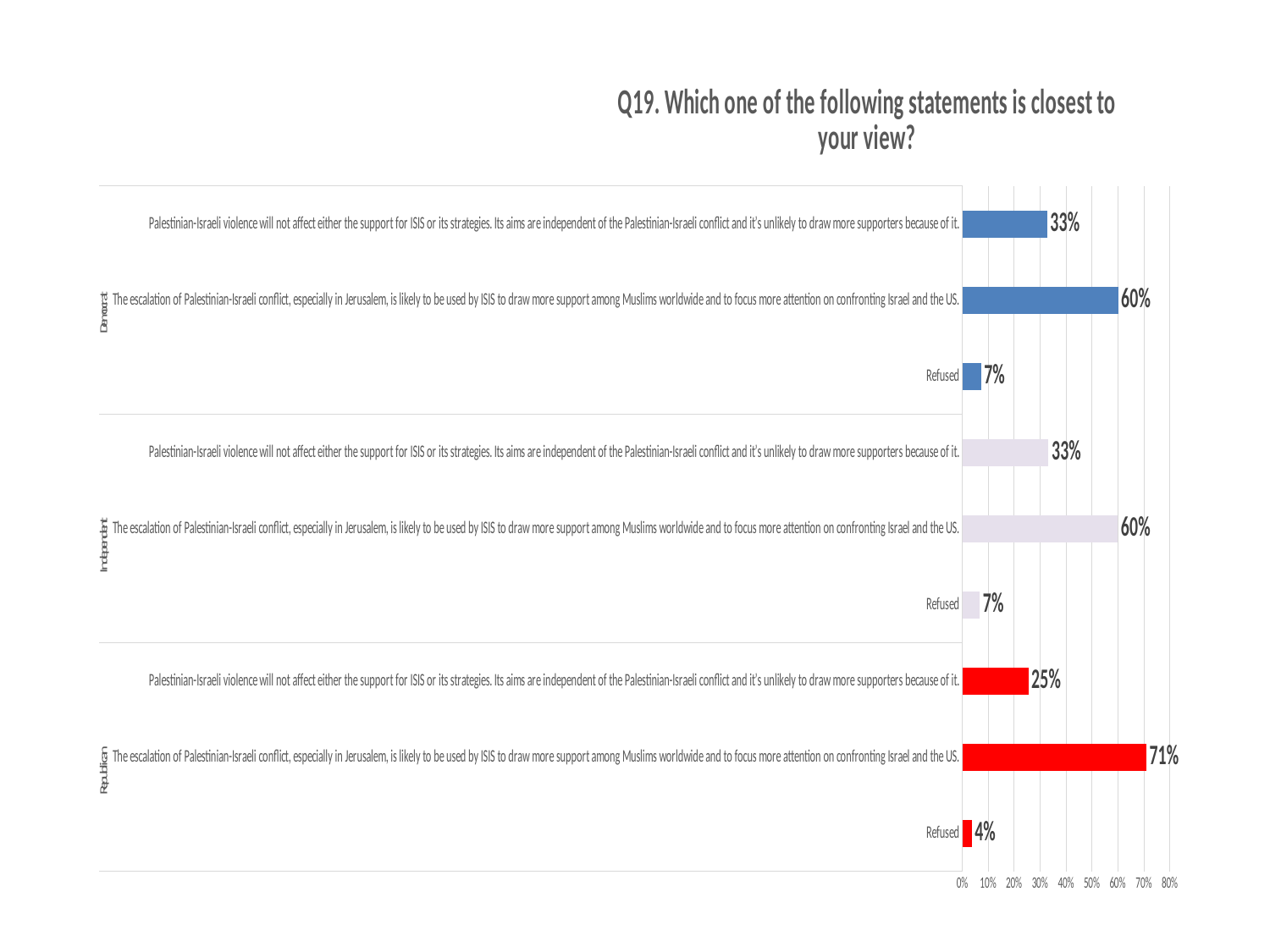
What is the value for Refused among Independents? 7% Which bar has the lowest value on the chart? Republican – Refused (4%) What percentage of Democrats chose the statement that Palestinian-Israeli violence will not affect support for ISIS or its strategies? 33% What is the value for Refused among Republicans? 4% What is the title of the chart? Q19. Which one of the following statements is closest to your view? Which is larger: the Democrat value or the Republican value for the statement that Palestinian-Israeli violence will not affect support for ISIS? Democrat How many bars are plotted on the chart in total? 9 What is the value for Republicans who chose the statement that the escalation of the Palestinian-Israeli conflict is likely to be used by ISIS to draw more support? 71% What is the difference between the Republican and Democrat values for the statement that the escalation of the conflict is likely to be used by ISIS to draw more support? 11% Which bar has the highest value on the chart? Republican – The escalation of Palestinian-Israeli conflict is likely to be used by ISIS to draw more support (71%) Is the Independent value for the statement that the escalation of the conflict is likely to be used by ISIS greater or less than 50%? greater What type of chart is shown on the slide? bar chart